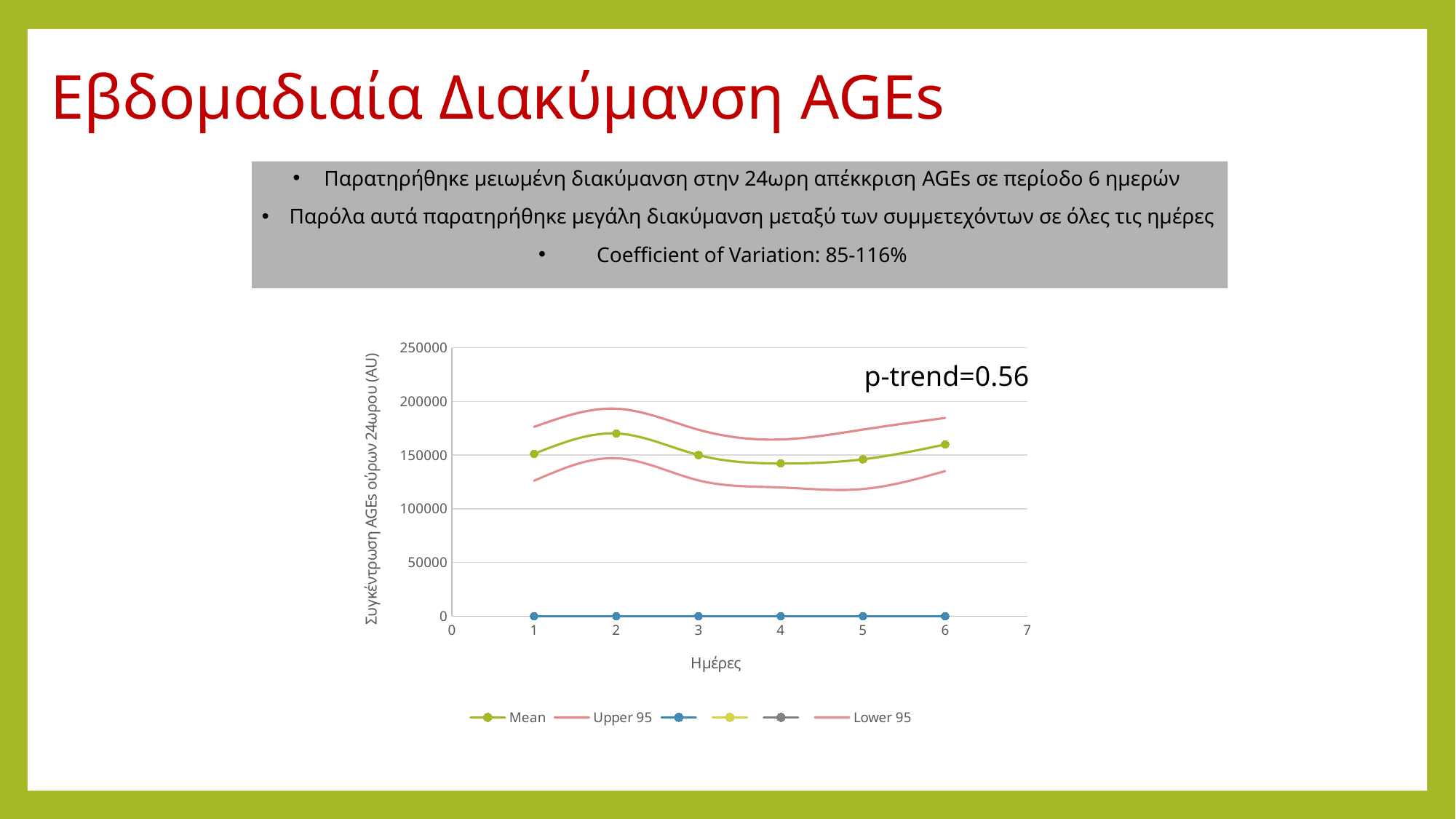
What kind of chart is shown on the slide? line chart Is the Lower 95 value on day 4 greater or less than 100000? greater On which day does the Mean series reach its highest value? 2 How many data points does the Mean series have? 6 Does the Mean series rise or fall from day 2 to day 4? fall What p-trend value is printed on the chart? p-trend=0.56 Is the Mean value on day 2 greater or less than 150000? greater Is the Upper 95 value on day 2 greater or less than 150000? greater Which has the larger Mean value, day 2 or day 6? day 2 What is the label of the x axis? Ημέρες